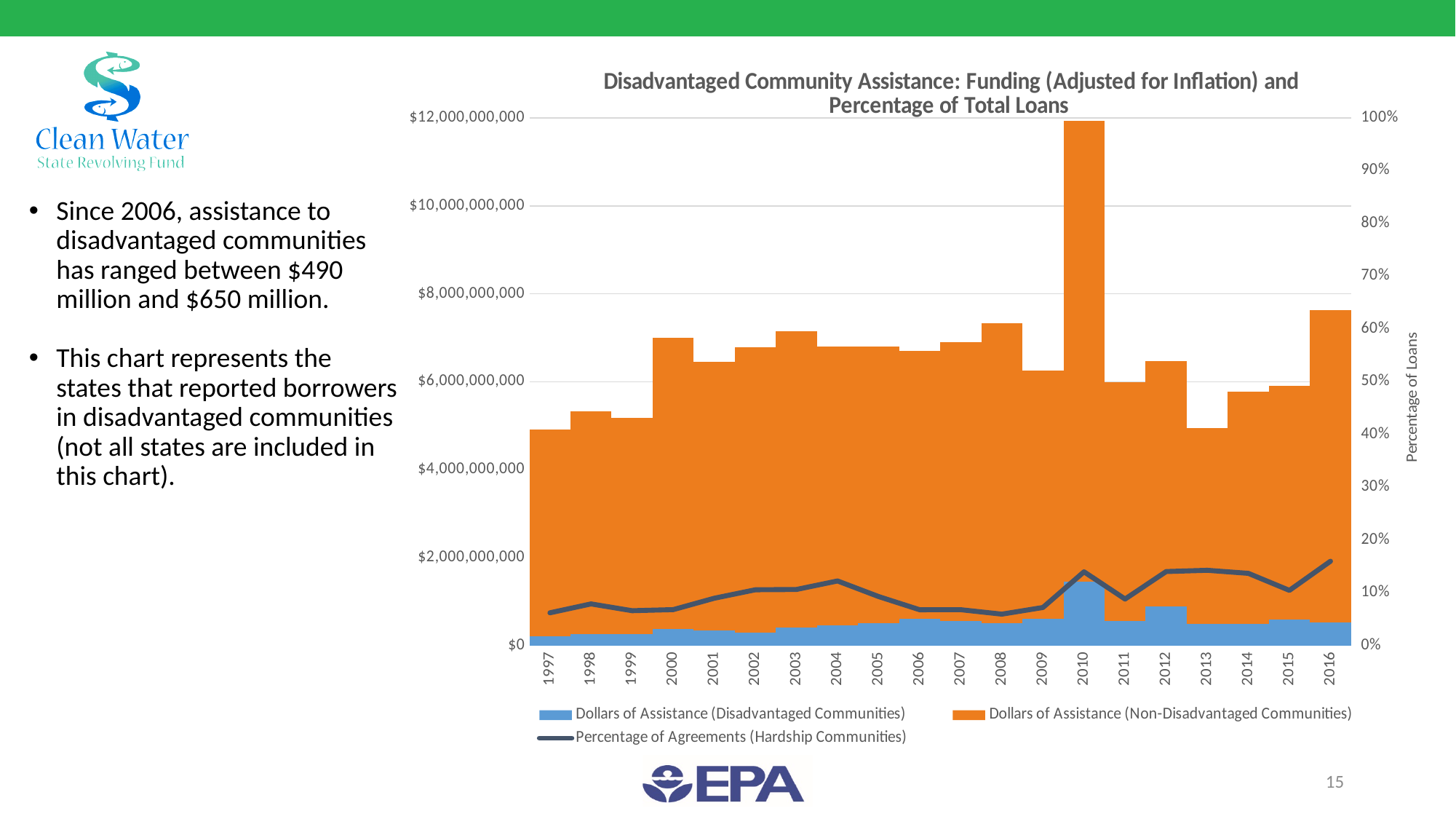
Is the total stacked bar for 1997 greater or less than $6,000,000,000? less Is the total stacked bar for 2016 greater or less than $6,000,000,000? greater Is the Percentage of Agreements (Hardship Communities) line for 1997 greater or less than 10%? less What is the title of the chart? Disadvantaged Community Assistance: Funding (Adjusted for Inflation) and Percentage of Total Loans What kind of chart is shown on the slide? Stacked bar chart with a line How many series does the chart's legend list? 3 Which year has the tallest stacked bar in the chart? 2010 Which year has the larger total stacked bar, 1999 or 2000? 2000 Does the total stacked bar rise or fall from 2010 to 2011? fall How many years are shown along the x axis of the chart? 20 What colour represents Dollars of Assistance (Disadvantaged Communities) in the chart? Blue